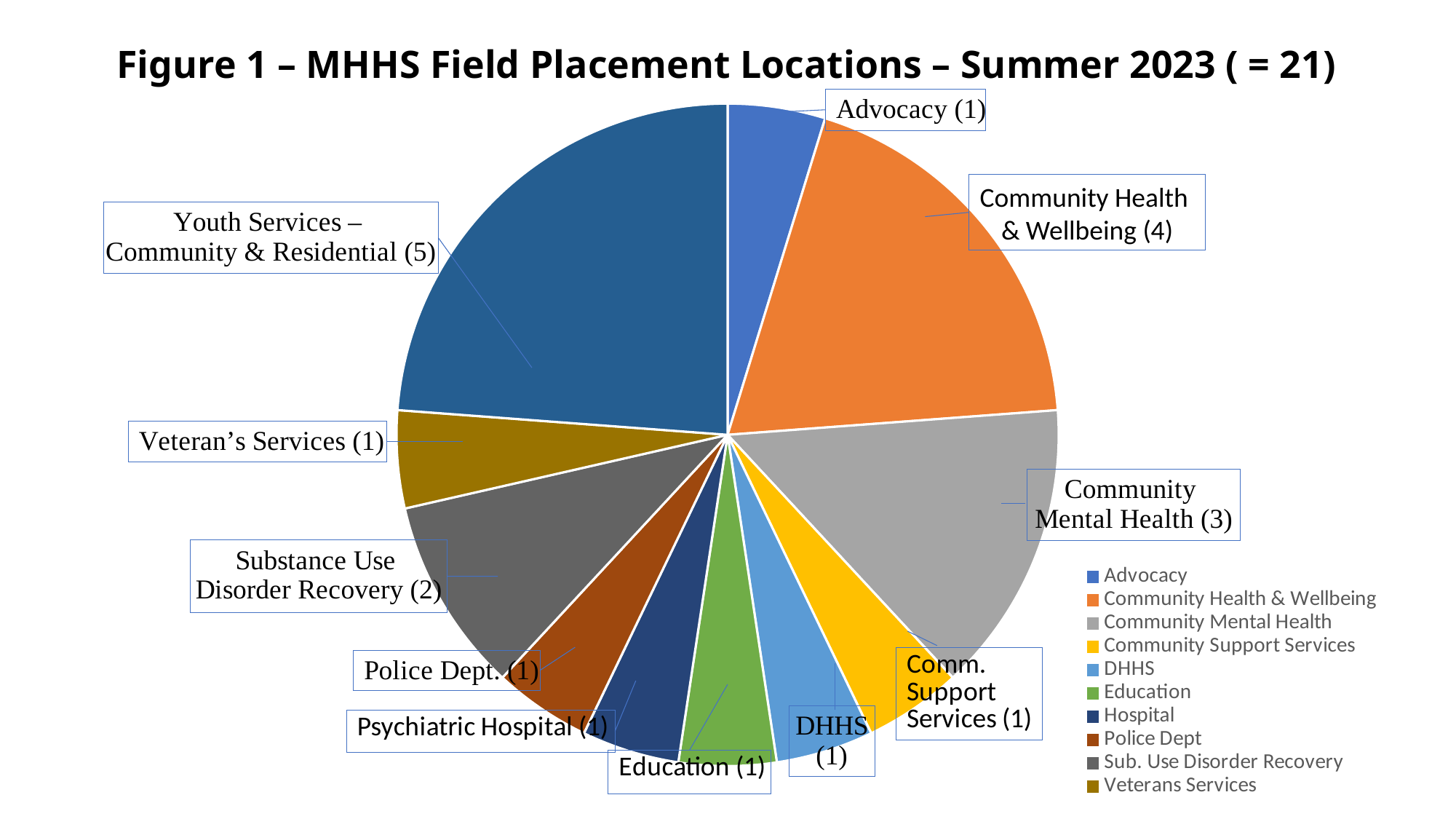
What is the title of the chart? Figure 1 – MHHS Field Placement Locations – Summer 2023 ( = 21) How many placements are in Youth Services – Community & Residential? 5 What is the total number of placements shown in the chart title? 21 What type of chart is shown on the slide? pie chart Which has more placements, Community Health & Wellbeing or Community Mental Health? Community Health & Wellbeing How many entries does the legend list? 10 How many placements are in Community Health & Wellbeing? 4 How many placements are in Community Mental Health? 3 How many slices does the pie chart have? 11 How many placements are in Substance Use Disorder Recovery? 2 Which placement location has the largest slice of the pie? Youth Services – Community & Residential What is the difference between the number of placements in Youth Services – Community & Residential and Community Mental Health? 2